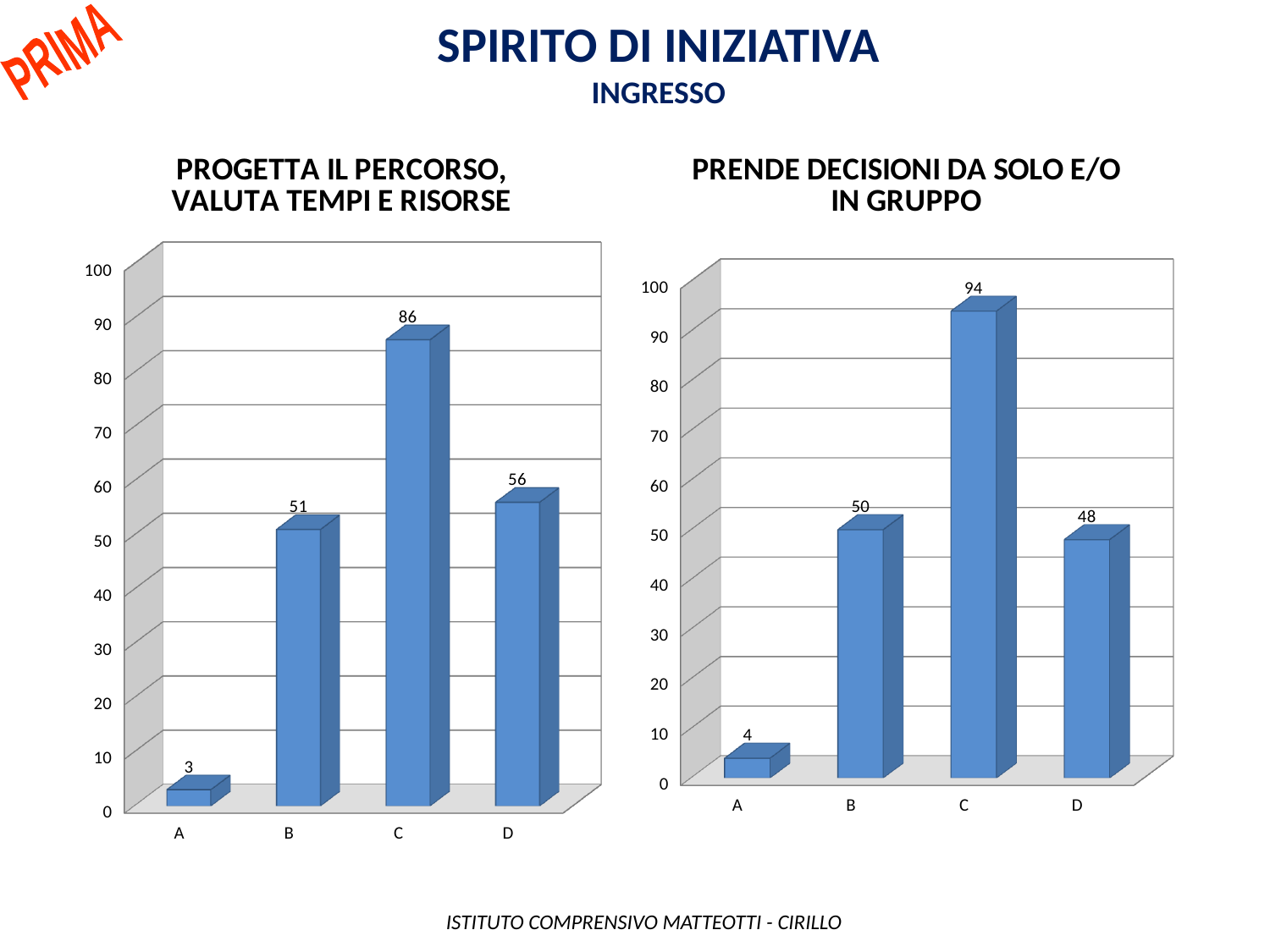
In the left chart 'PROGETTA IL PERCORSO, VALUTA TEMPI E RISORSE', which is larger, the value for B or the value for D? D In the right chart 'PRENDE DECISIONI DA SOLO E/O IN GRUPPO', what is the value for category A? 4 What kind of chart is the right chart 'PRENDE DECISIONI DA SOLO E/O IN GRUPPO'? bar chart How many categories are shown in the left chart 'PROGETTA IL PERCORSO, VALUTA TEMPI E RISORSE'? 4 In the right chart 'PRENDE DECISIONI DA SOLO E/O IN GRUPPO', which category has the highest value? C In the right chart 'PRENDE DECISIONI DA SOLO E/O IN GRUPPO', what is the difference between the values for C and D? 46 In the left chart 'PROGETTA IL PERCORSO, VALUTA TEMPI E RISORSE', which category has the lowest value? A In the right chart 'PRENDE DECISIONI DA SOLO E/O IN GRUPPO', what is the value for category D? 48 In the left chart 'PROGETTA IL PERCORSO, VALUTA TEMPI E RISORSE', what is the value for category C? 86 In the left chart 'PROGETTA IL PERCORSO, VALUTA TEMPI E RISORSE', what is the difference between the values for C and B? 35 In the right chart 'PRENDE DECISIONI DA SOLO E/O IN GRUPPO', is the value for B greater or less than 40? greater What is the main title of the slide? SPIRITO DI INIZIATIVA